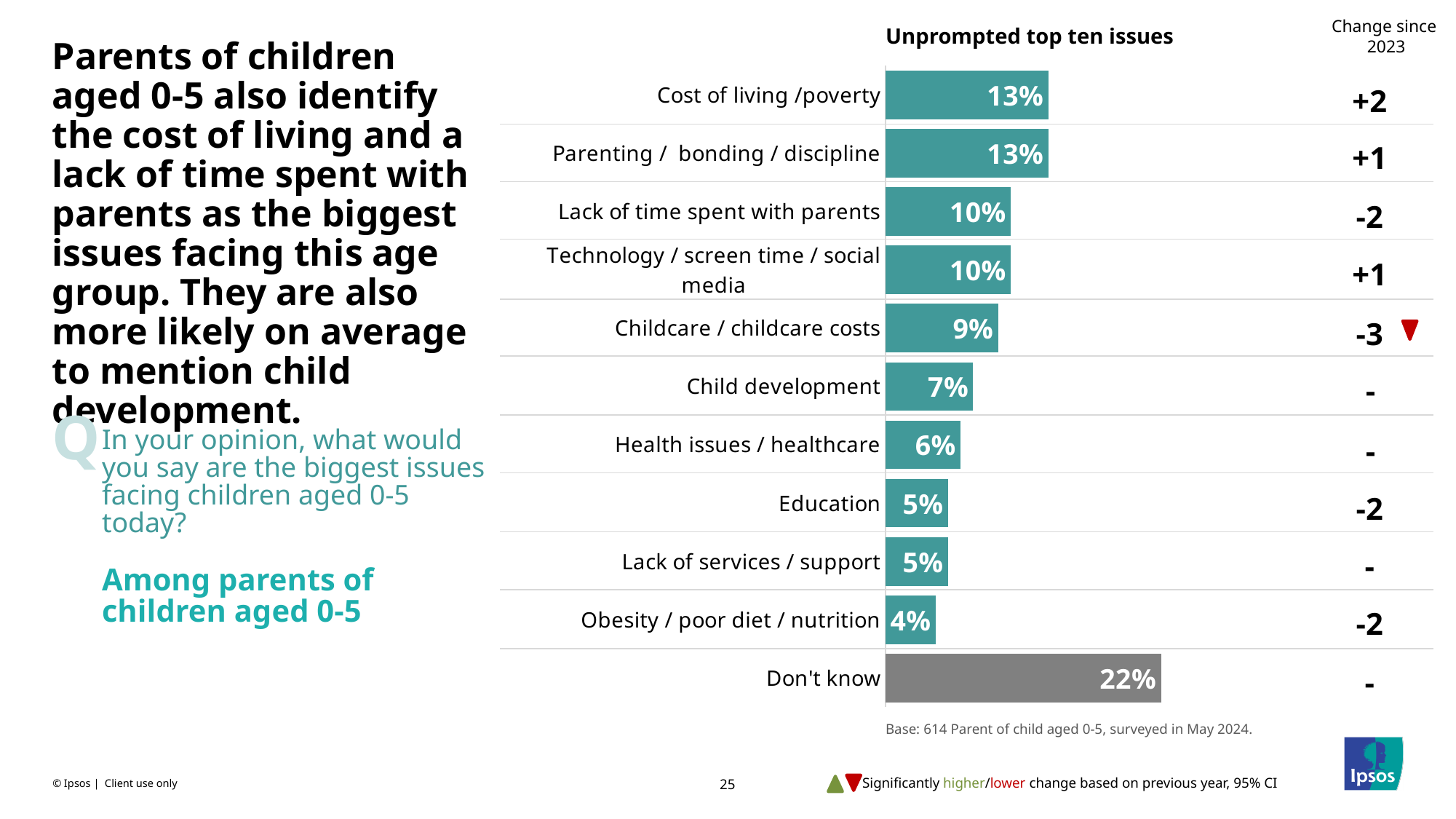
What is the value for Obesity / poor diet / nutrition? 4% What is the value shown for Childcare / childcare costs? 9% Which is larger, the value for Health issues / healthcare or the value for Education? Health issues / healthcare What percentage of parents of children aged 0-5 mentioned Cost of living /poverty as a biggest issue? 13% What kind of chart is shown on the slide? Bar chart What percentage is shown for Don't know? 22% How many issue categories are plotted in the chart, including Don't know? 11 What is the difference between the value for Cost of living /poverty and the value for Child development? 6% Which of the ten issues has the lowest percentage? Obesity / poor diet / nutrition Which bar in the chart is coloured grey rather than teal? Don't know What is the change since 2023 shown for Childcare / childcare costs? -3 What is the title of the chart? Unprompted top ten issues